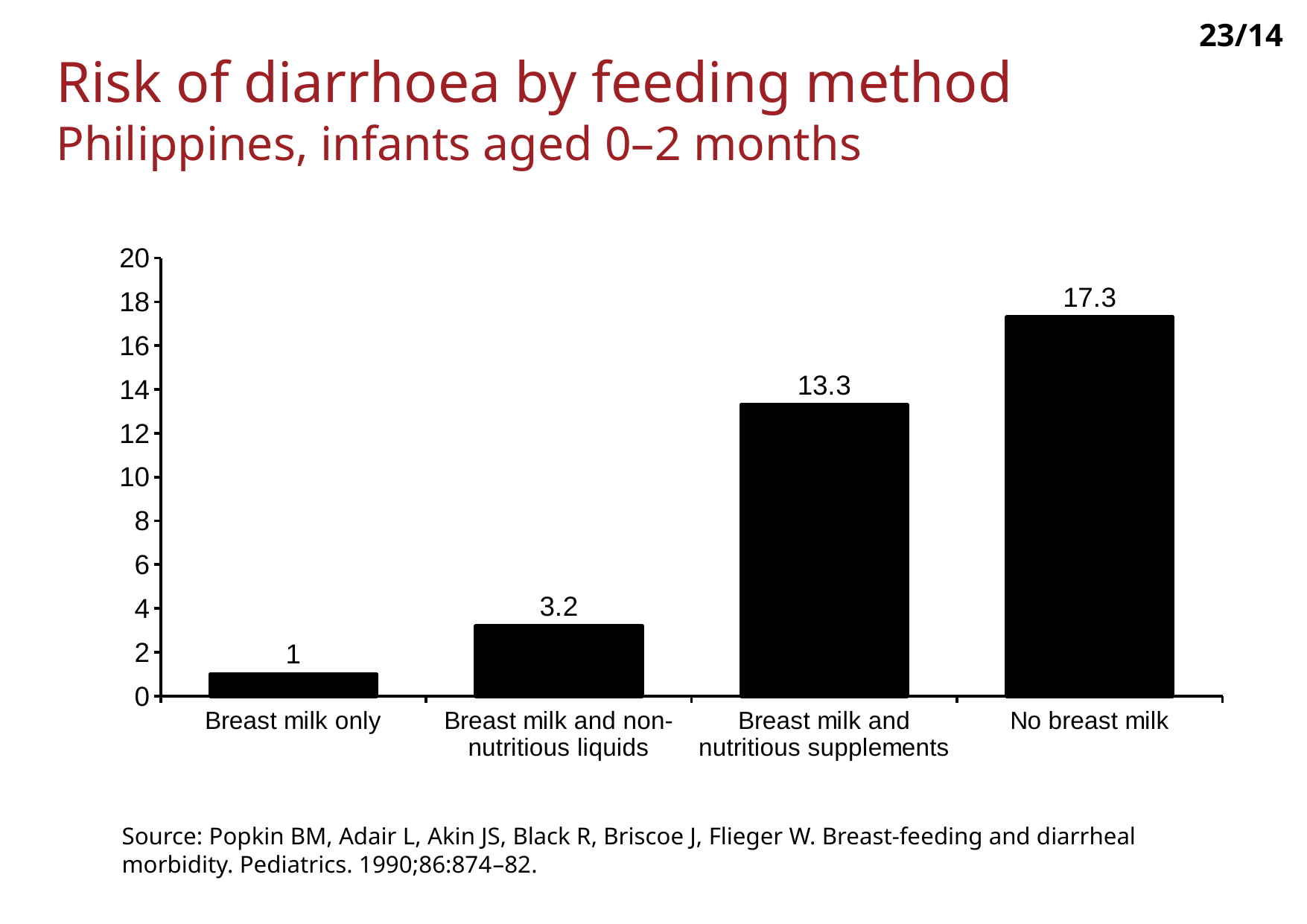
What is the value for Breast milk only? 1 Which is larger, the value for Breast milk and nutritious supplements or the value for Breast milk and non-nutritious liquids? Breast milk and nutritious supplements Which feeding method has the lowest risk of diarrhoea? Breast milk only How many feeding method categories are shown in the chart? 4 What is the value for Breast milk and nutritious supplements? 13.3 What is the difference between the values for No breast milk and Breast milk and nutritious supplements? 4 What is the difference between the values for Breast milk and non-nutritious liquids and Breast milk only? 2.2 What is the value for Breast milk and non-nutritious liquids? 3.2 What kind of chart is shown on the slide? Bar chart What is the value for No breast milk? 17.3 Which feeding method has the highest risk of diarrhoea? No breast milk Do the values rise or fall from left to right across the categories? Rise